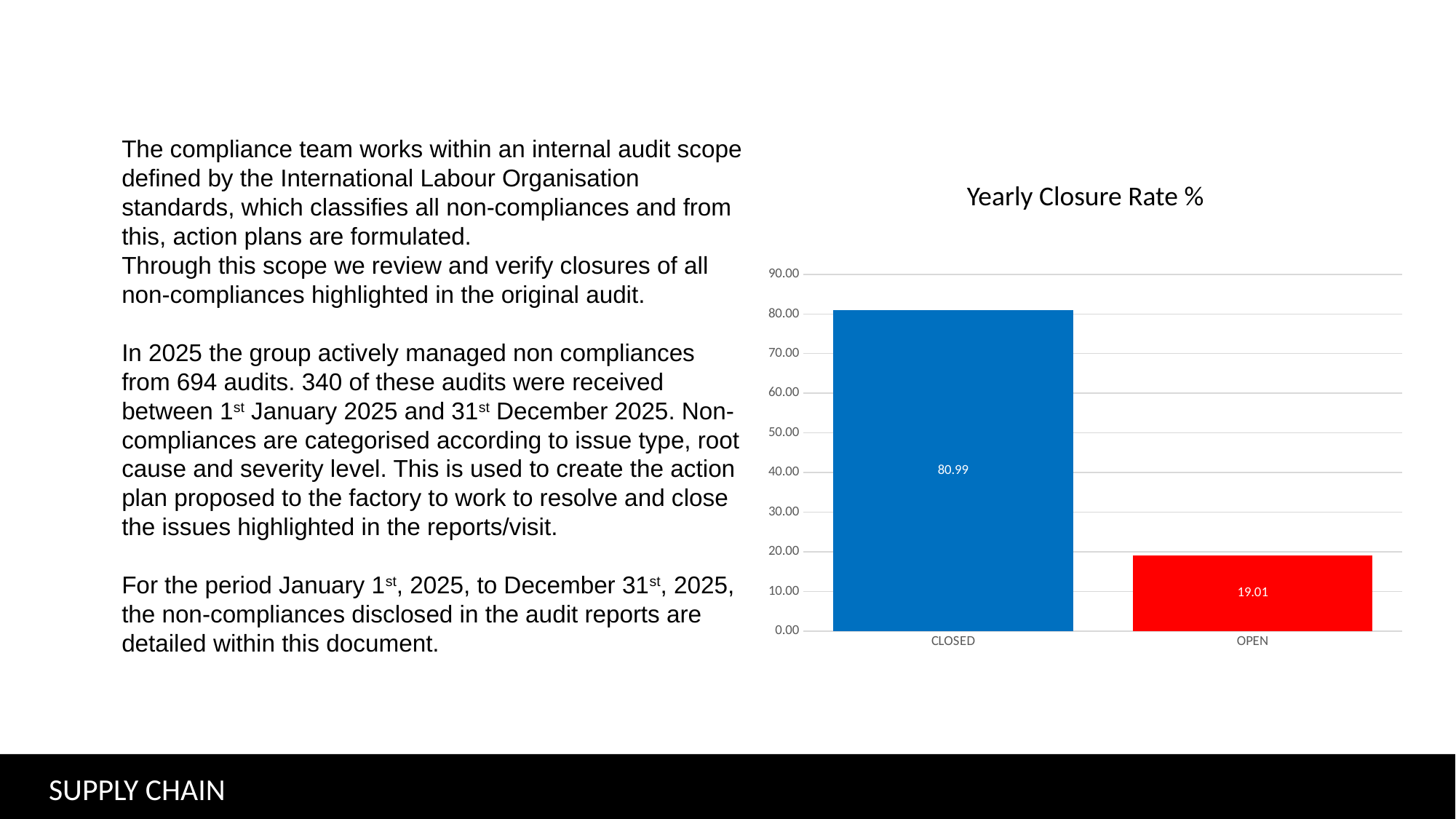
How many categories are shown in the Yearly Closure Rate % chart? 2 What kind of chart is the Yearly Closure Rate % chart? bar chart Is the value for OPEN greater or less than 20.00 in the Yearly Closure Rate % chart? less What is the title of the chart on the slide? Yearly Closure Rate % What is the value for CLOSED in the Yearly Closure Rate % chart? 80.99 Which is larger in the Yearly Closure Rate % chart, CLOSED or OPEN? CLOSED What is the difference between the CLOSED and OPEN values in the Yearly Closure Rate % chart? 61.98 Which category has the highest value in the Yearly Closure Rate % chart? CLOSED What is the value for OPEN in the Yearly Closure Rate % chart? 19.01 Is the value for CLOSED greater or less than 80.00 in the Yearly Closure Rate % chart? greater What colour is the OPEN bar in the Yearly Closure Rate % chart? red Which category has the lowest value in the Yearly Closure Rate % chart? OPEN